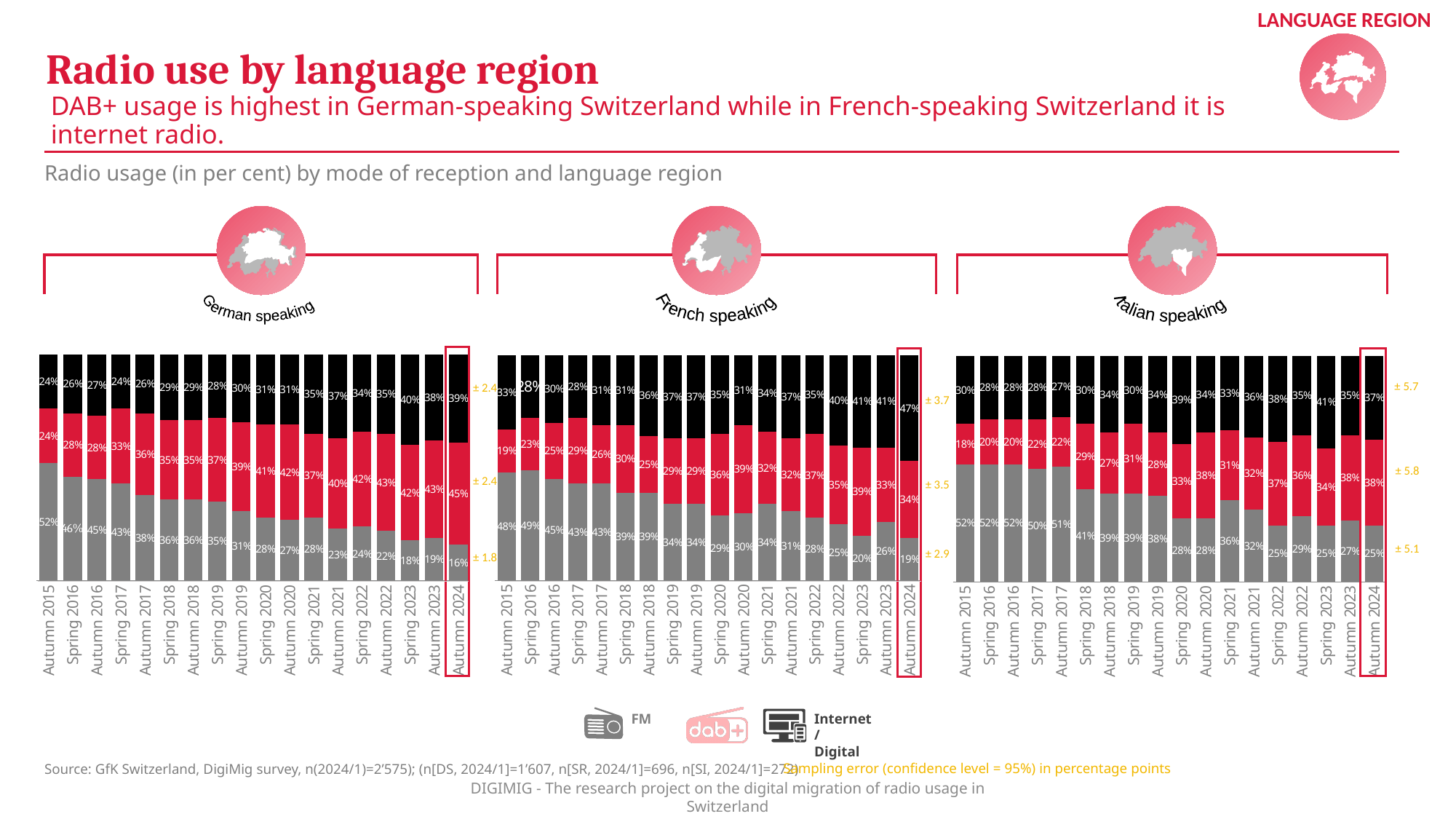
In the German speaking chart, what is the FM share in Autumn 2024? 16% In the German speaking chart, which period has the lowest FM share? Autumn 2024 In the French speaking chart, does the FM share generally rise or fall from Autumn 2015 to Autumn 2024? Fall How many modes of reception does the legend list? 3 What kind of chart is used for each language region? Stacked bar chart In the German speaking chart, what is the DAB+ share in Autumn 2015? 24% In the French speaking chart, what is the Internet/Digital share in Autumn 2024? 47% In the French speaking chart, which period has the highest Internet/Digital share? Autumn 2024 How many periods are shown on the x axis of the German speaking chart? 18 In the Italian speaking chart, which is larger in Autumn 2024: the FM share or the DAB+ share? DAB+ In the Italian speaking chart, what is the DAB+ share in Autumn 2024? 38% In the German speaking chart, what is the difference between the FM share in Autumn 2015 and in Autumn 2024? 36 percentage points